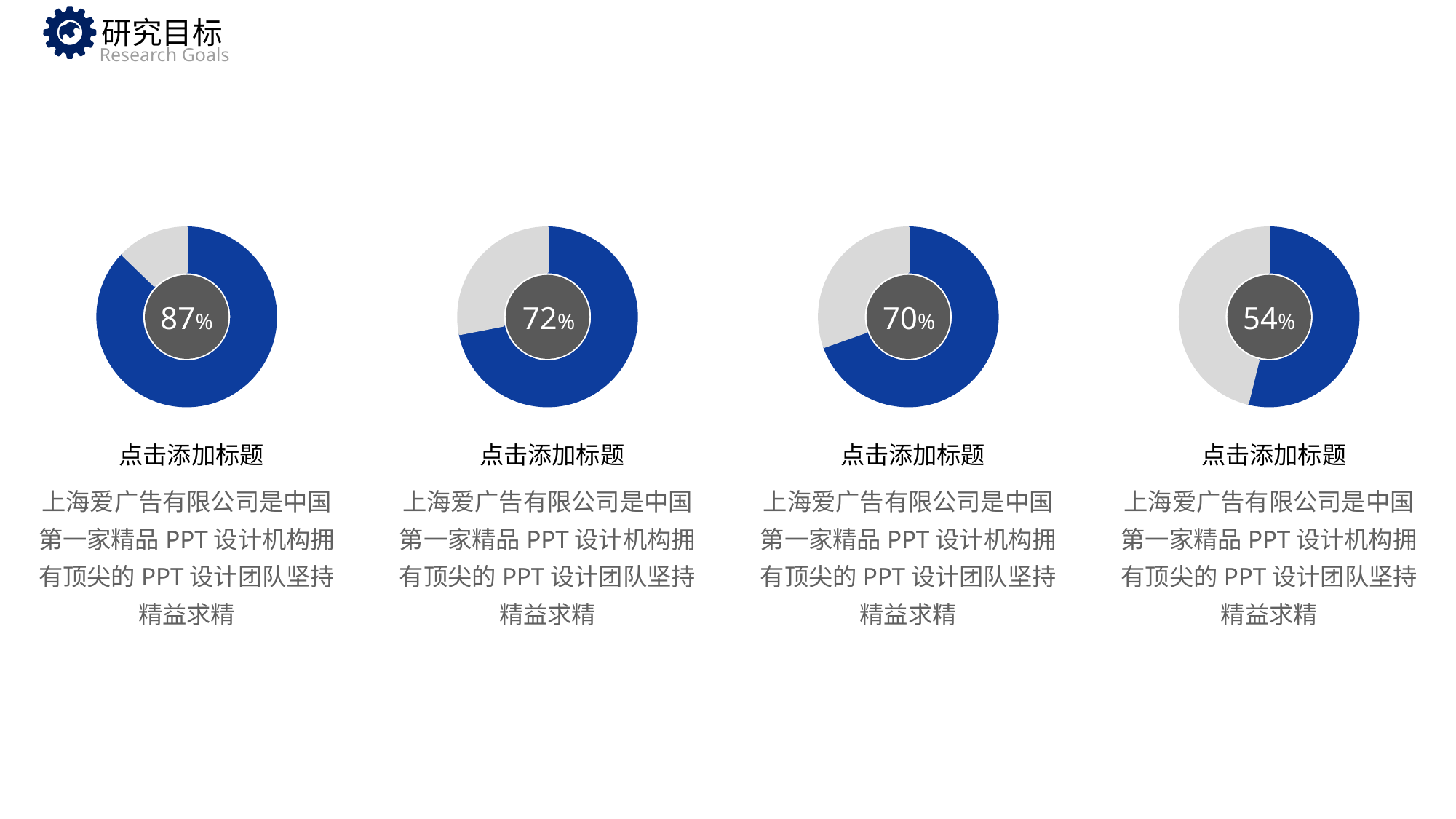
Which of the four donut charts shows the lowest percentage? The rightmost chart (54%) In the rightmost donut chart, what share of the ring is filled in blue? 54% Which is larger: the percentage in the second donut chart from the left or the percentage in the third donut chart from the left? The second chart from the left (72%) What colour is used for the filled portion of each donut chart? Blue What value is shown in the centre of the third donut chart from the left? 70% How many donut charts are shown on the slide? 4 What value is shown in the centre of the second donut chart from the left? 72% What kind of chart is used for each of the four figures on the slide? Donut (pie) chart Which of the four donut charts shows the highest percentage? The leftmost chart (87%) What value is shown in the centre of the leftmost donut chart? 87% What value is shown in the centre of the rightmost donut chart? 54% What is the difference between the percentage in the leftmost donut chart and the percentage in the rightmost donut chart? 33 percentage points